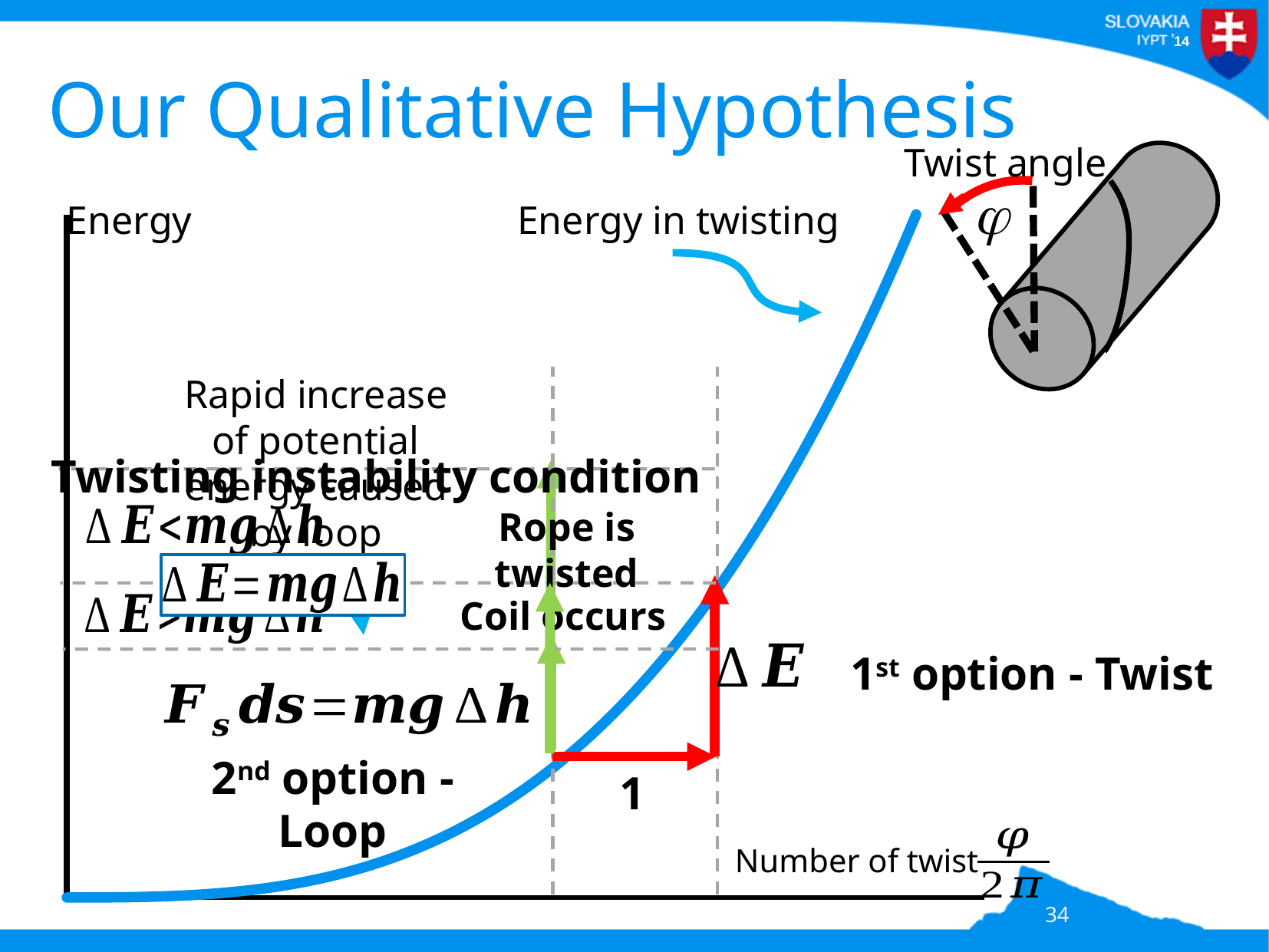
What kind of chart is shown on the slide? line chart Does the energy curve rise or fall as the number of twists increases along the x axis? rises What is the label of the horizontal axis of the chart? Number of twist φ/2π What is the label of the vertical axis of the chart? Energy What value is printed for the horizontal step between the two dashed vertical lines on the chart? 1